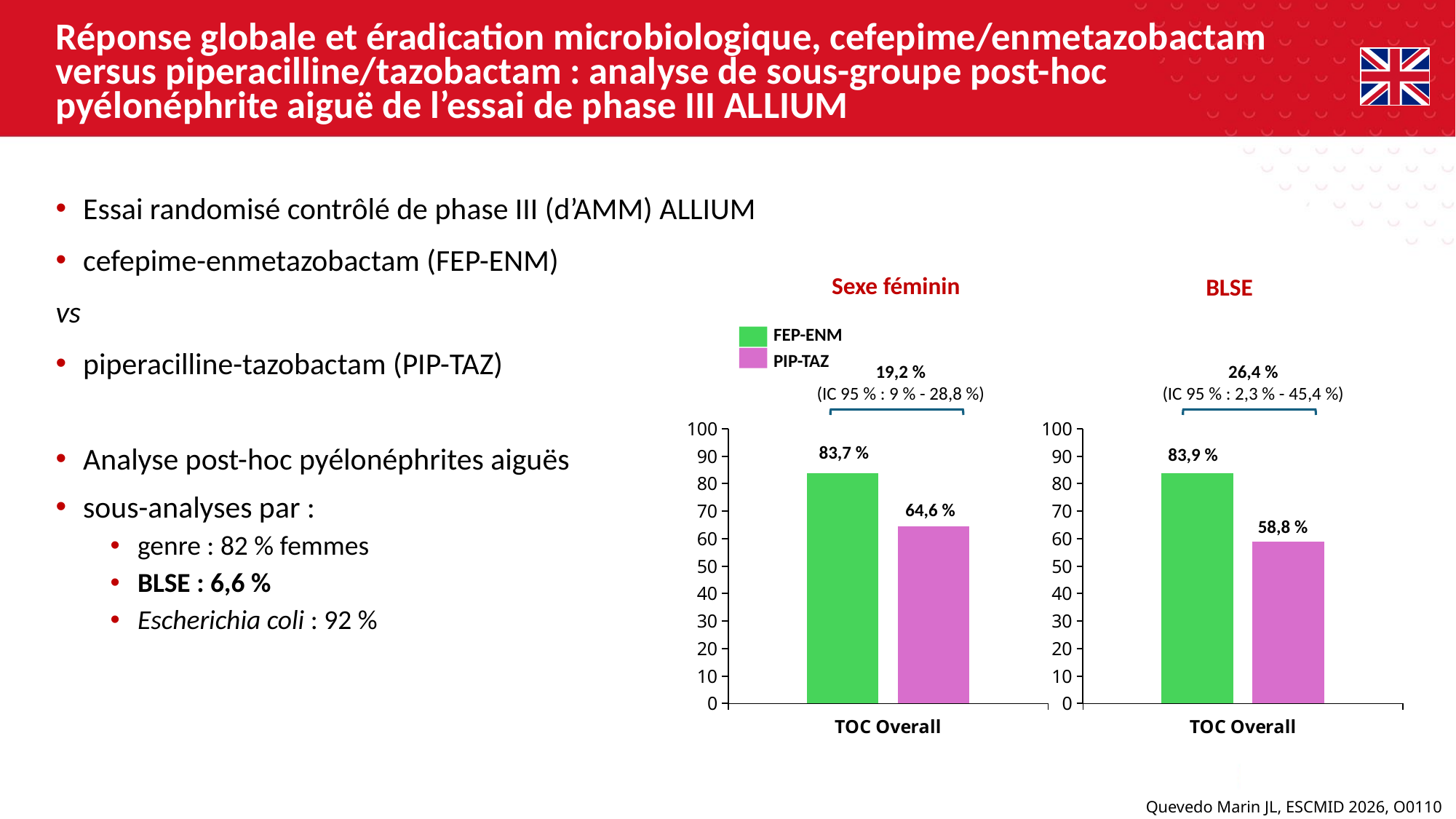
In the 'BLSE' chart, which series has the lower value at TOC Overall? PIP-TAZ What kind of chart is the 'Sexe féminin' chart? Bar chart In the 'BLSE' chart, what is the value for FEP-ENM at TOC Overall? 83,9 % In the 'Sexe féminin' chart, what is the value for PIP-TAZ at TOC Overall? 64,6 % In the 'Sexe féminin' chart, what is the difference between the FEP-ENM and PIP-TAZ values shown above the bars? 19,2 % In the legend, which colour represents PIP-TAZ? Purple In the 'Sexe féminin' chart, what is the value for FEP-ENM at TOC Overall? 83,7 % In the 'BLSE' chart, what is the difference between the FEP-ENM and PIP-TAZ values shown above the bars? 26,4 % In the 'BLSE' chart, is the value for PIP-TAZ greater or less than 60? less How many series does the legend list for the charts? 2 In the 'Sexe féminin' chart, which series has the higher value at TOC Overall? FEP-ENM In the 'BLSE' chart, what is the value for PIP-TAZ at TOC Overall? 58,8 %